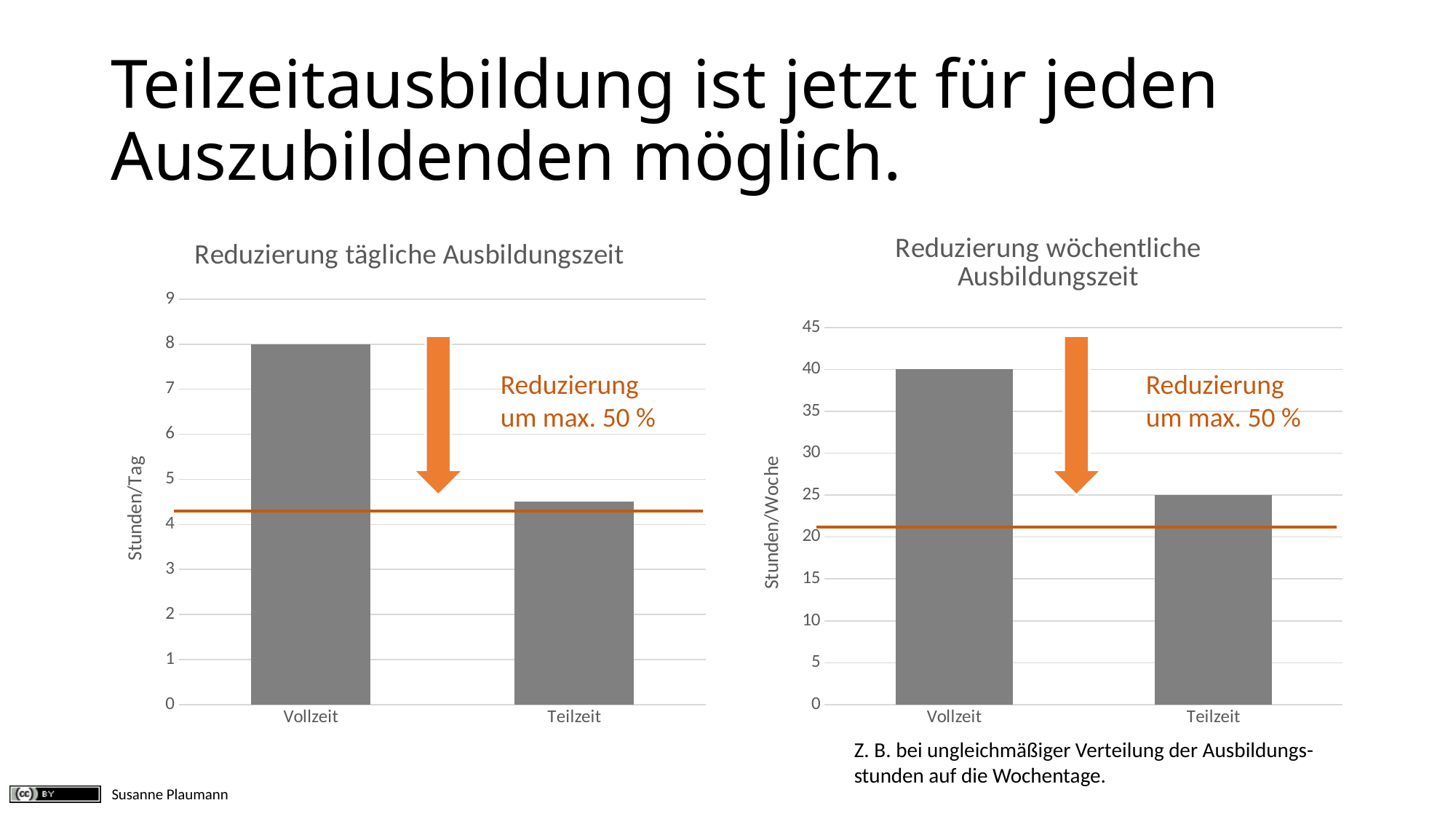
What kind of chart is the chart titled "Reduzierung tägliche Ausbildungszeit"? bar chart What is the y-axis title of the chart titled "Reduzierung wöchentliche Ausbildungszeit"? Stunden/Woche In the chart titled "Reduzierung tägliche Ausbildungszeit", is the value for Teilzeit greater or less than 4? greater In the chart titled "Reduzierung tägliche Ausbildungszeit", what is the value for Vollzeit? 8 In the chart titled "Reduzierung tägliche Ausbildungszeit", which is larger, the value for Vollzeit or the value for Teilzeit? Vollzeit In the chart titled "Reduzierung wöchentliche Ausbildungszeit", which category has the lowest value? Teilzeit How many categories are shown in the chart titled "Reduzierung wöchentliche Ausbildungszeit"? 2 In the chart titled "Reduzierung wöchentliche Ausbildungszeit", what is the difference between the Vollzeit and Teilzeit values? 15 In the chart titled "Reduzierung wöchentliche Ausbildungszeit", what is the value for Teilzeit? 25 In the chart titled "Reduzierung tägliche Ausbildungszeit", is the value for Teilzeit greater or less than 5? less In the chart titled "Reduzierung wöchentliche Ausbildungszeit", what is the value for Vollzeit? 40 In the chart titled "Reduzierung tägliche Ausbildungszeit", which category has the highest value? Vollzeit